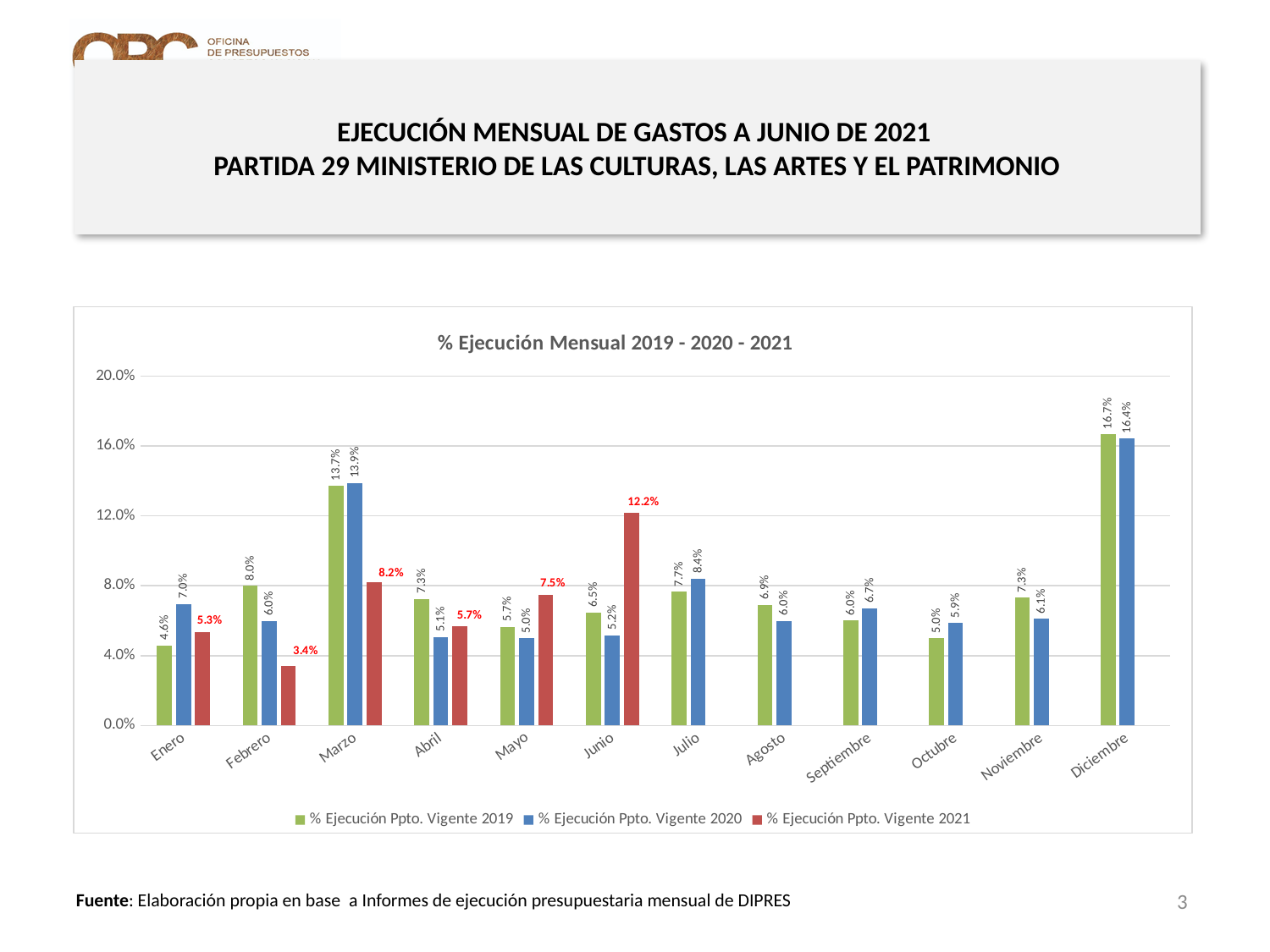
Is the value for % Ejecución Ppto. Vigente 2020 in Marzo greater or less than 12.0%? greater What kind of chart is shown on the slide? Bar chart What is the value for % Ejecución Ppto. Vigente 2019 in Marzo? 13.7% How many series does the legend list? 3 Which month has the highest value for % Ejecución Ppto. Vigente 2019? Diciembre How many months are shown on the x axis? 12 What is the value for % Ejecución Ppto. Vigente 2021 in Junio? 12.2% In Febrero, which is larger: the 2019 value or the 2020 value? 2019 Which month has the highest value for % Ejecución Ppto. Vigente 2021? Junio What is the value for % Ejecución Ppto. Vigente 2020 in Diciembre? 16.4% Which month has the lowest value for % Ejecución Ppto. Vigente 2021? Febrero What is the difference between the 2021 and 2020 values in Junio? 7.0%